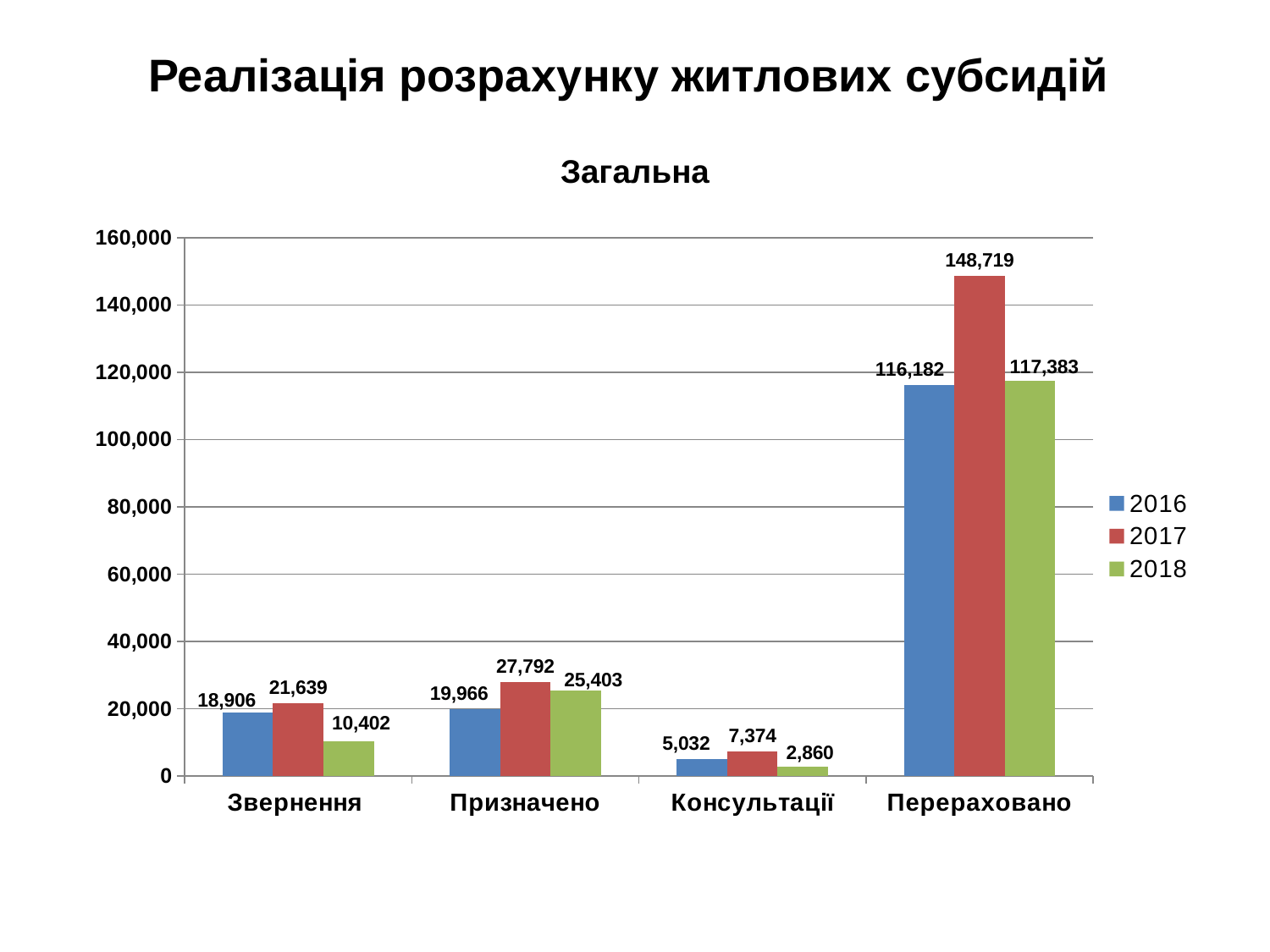
What is the value for 2018 in the Звернення category? 10,402 Which category has the lowest value for the 2018 series? Консультації What is the difference between the 2017 and 2016 values in the Перераховано category? 32,537 What is the value for 2016 in the Консультації category? 5,032 What is the value for 2017 in the Перераховано category? 148,719 How many categories are shown on the x axis? 4 How many series does the legend list? 3 Which is larger in the Звернення category: the 2016 value or the 2017 value? 2017 What kind of chart is shown on the slide? bar chart Which category has the highest value for the 2016 series? Перераховано Is the value for 2018 in the Перераховано category greater or less than 100,000? greater What is the difference between the 2017 and 2018 values in the Призначено category? 2,389